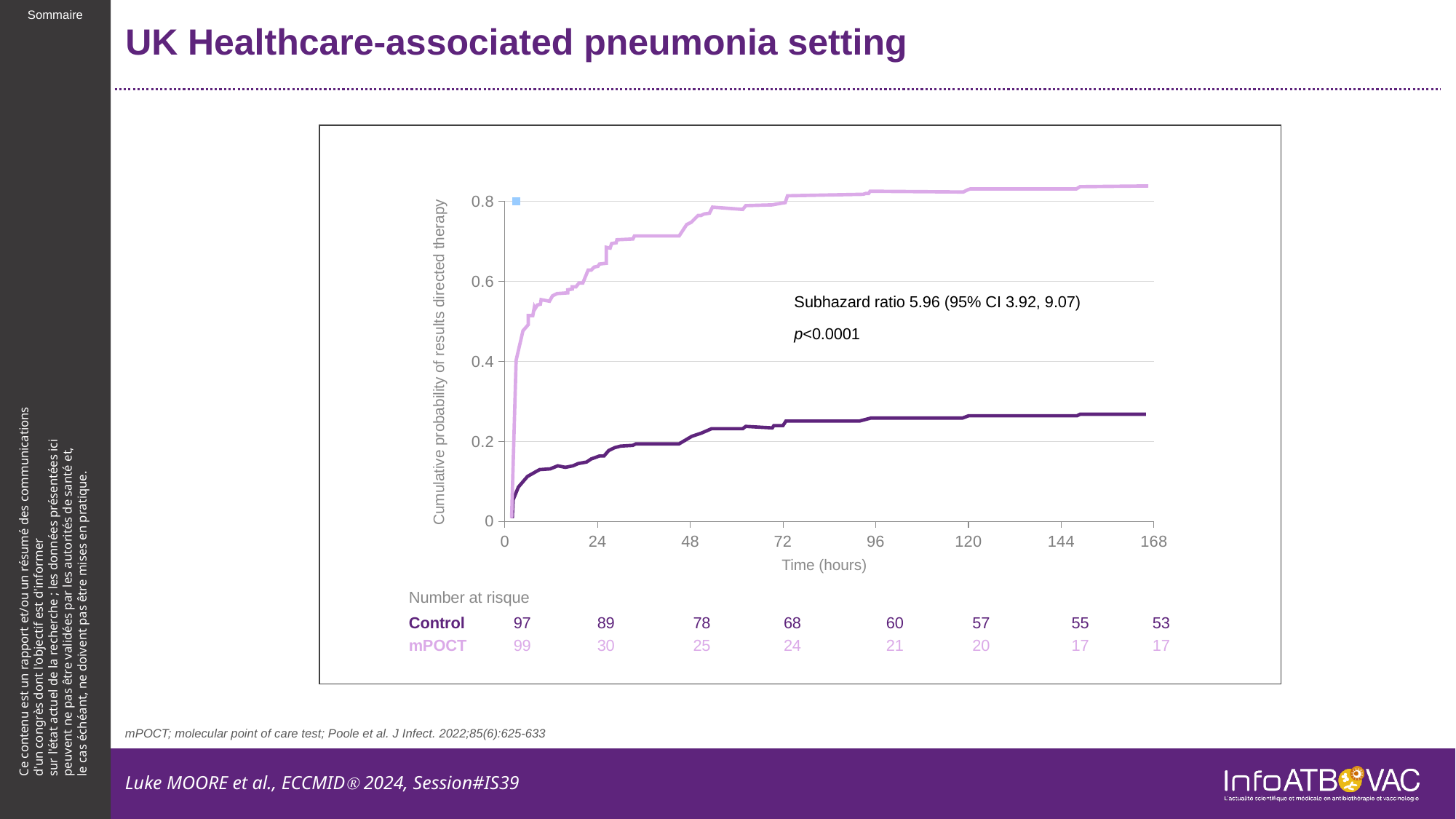
What is the difference between the Control and mPOCT numbers at risk at 168 hours? 36 Is the cumulative probability for mPOCT at 168 hours greater or less than 0.8? greater Which group has the higher cumulative probability of results directed therapy at 168 hours, Control or mPOCT? mPOCT In the number at risk table, how many Control patients are at risk at 168 hours? 53 How many series (groups) are plotted on the chart? 2 Is the cumulative probability for Control at 168 hours greater or less than 0.4? less Is the cumulative probability for mPOCT at 48 hours greater or less than 0.6? greater In the number at risk table, how many Control patients are at risk at time 0? 97 Do the curves rise or fall as time increases along the x axis? rise In the number at risk table, how many mPOCT patients are at risk at 24 hours? 30 What subhazard ratio is reported on the chart? 5.96 (95% CI 3.92, 9.07) What kind of chart is shown on the slide? line chart